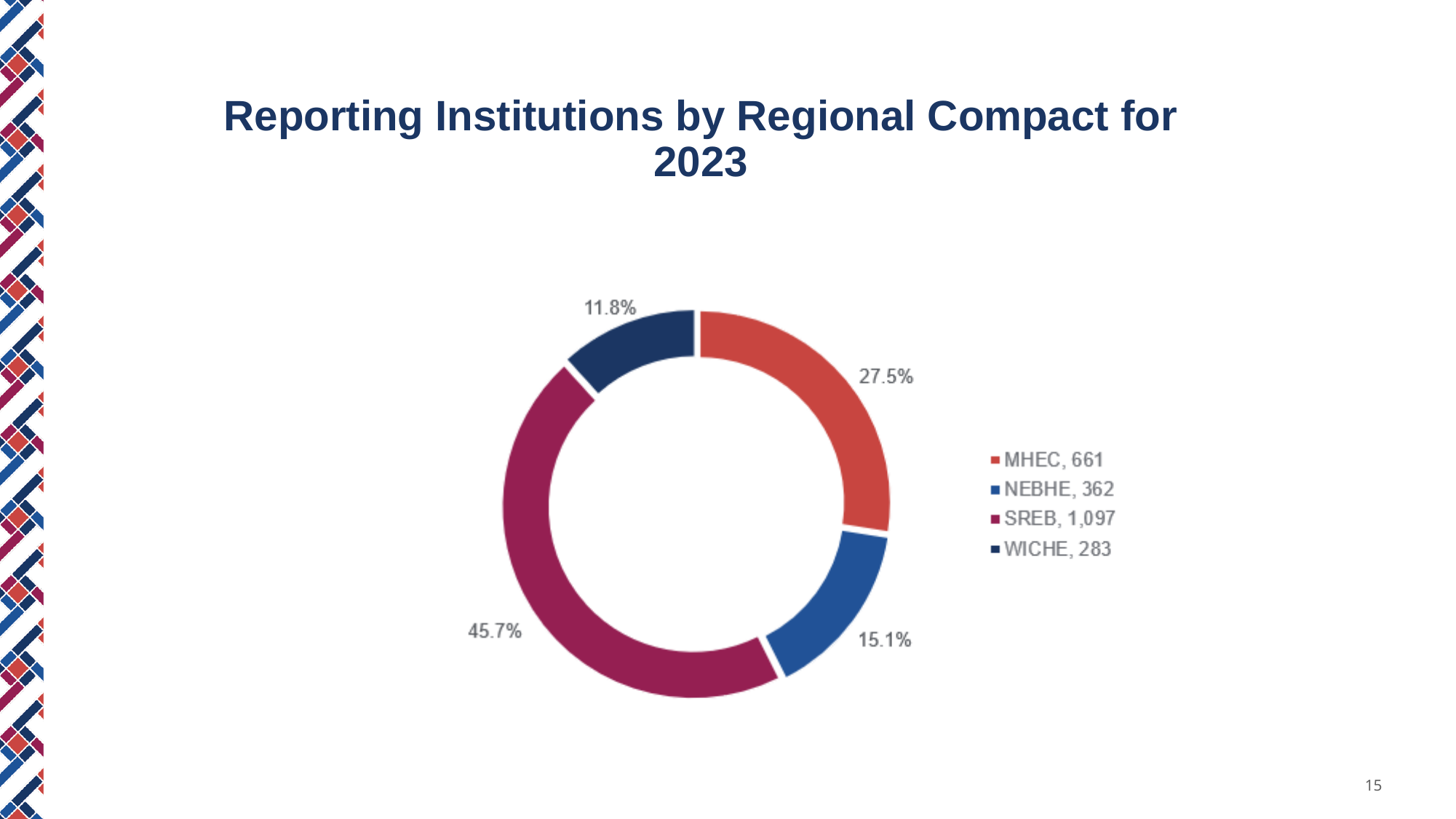
What is the difference in reporting institutions between MHEC and WICHE? 378 How many reporting institutions does the legend show for NEBHE? 362 What share of the pie does MHEC account for? 27.5% Which has more reporting institutions, NEBHE or MHEC? MHEC What kind of chart is shown on the slide? Pie chart (doughnut) Which regional compact has the smallest share of reporting institutions? WICHE Which regional compact has the largest share of reporting institutions? SREB How many reporting institutions does the legend show for SREB? 1,097 What share of the pie does SREB account for? 45.7% What is the title of the chart on the slide? Reporting Institutions by Regional Compact for 2023 What share of the pie does WICHE account for? 11.8% How many regional compacts are shown in the chart? 4